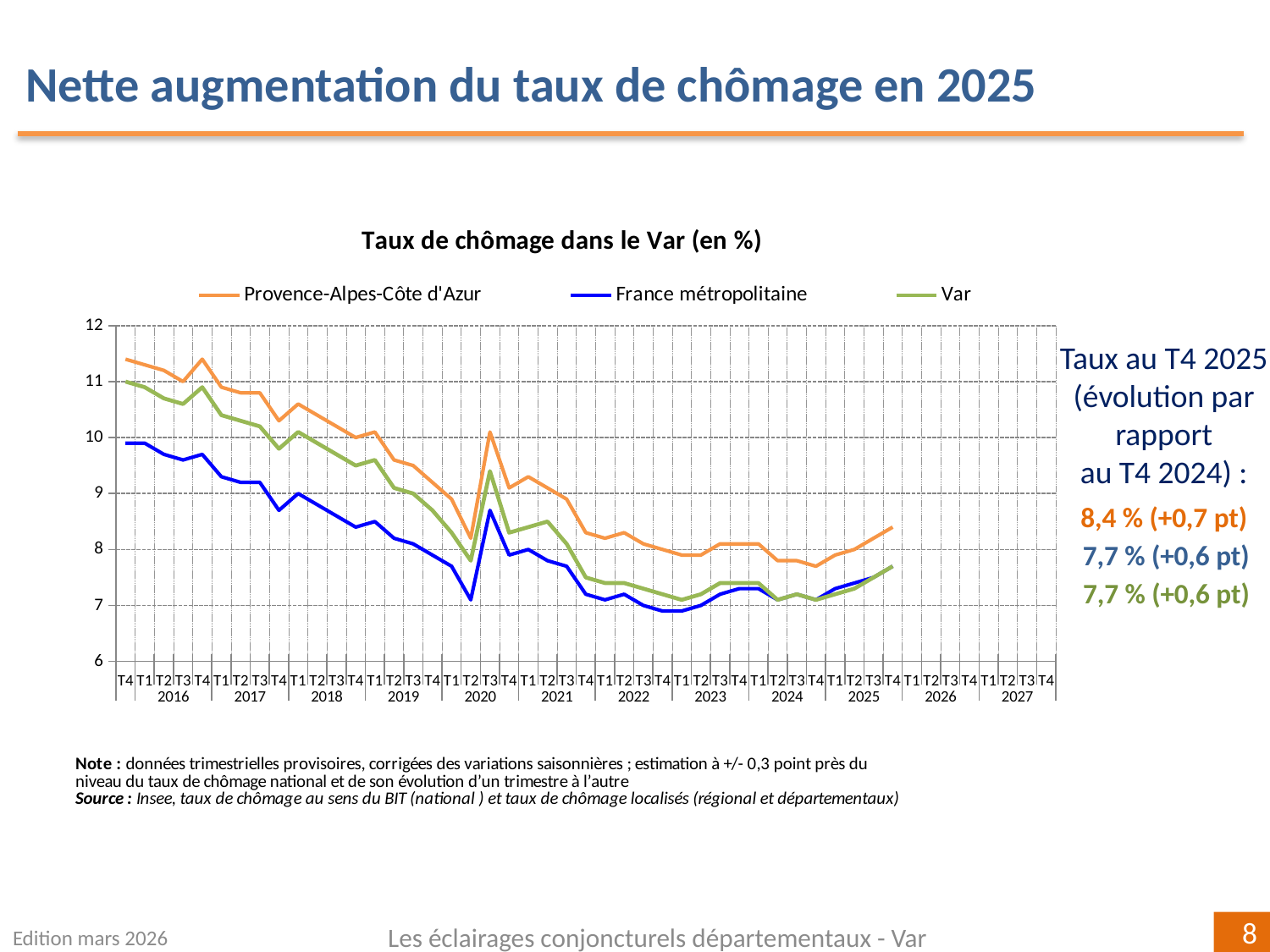
Which series has the highest value at T4 2025? Provence-Alpes-Côte d'Azur Is the value for Provence-Alpes-Côte d'Azur at T4 2015 greater or less than 11? greater How many series does the legend list? 3 What kind of chart is shown on the slide? line chart What is the unemployment rate for Provence-Alpes-Côte d'Azur at T4 2025? 8,4 % Is the value for France métropolitaine at T1 2020 greater or less than 8? less By how much did the Var unemployment rate change between T4 2024 and T4 2025? +0,6 pt Overall, do the unemployment rates rise or fall between 2016 and 2024? fall What is the difference between the Provence-Alpes-Côte d'Azur rate and the France métropolitaine rate at T4 2025? 0,7 pt What is the unemployment rate for Var at T4 2025? 7,7 % What is the unemployment rate for France métropolitaine at T4 2025? 7,7 % What is the title of the chart? Taux de chômage dans le Var (en %)